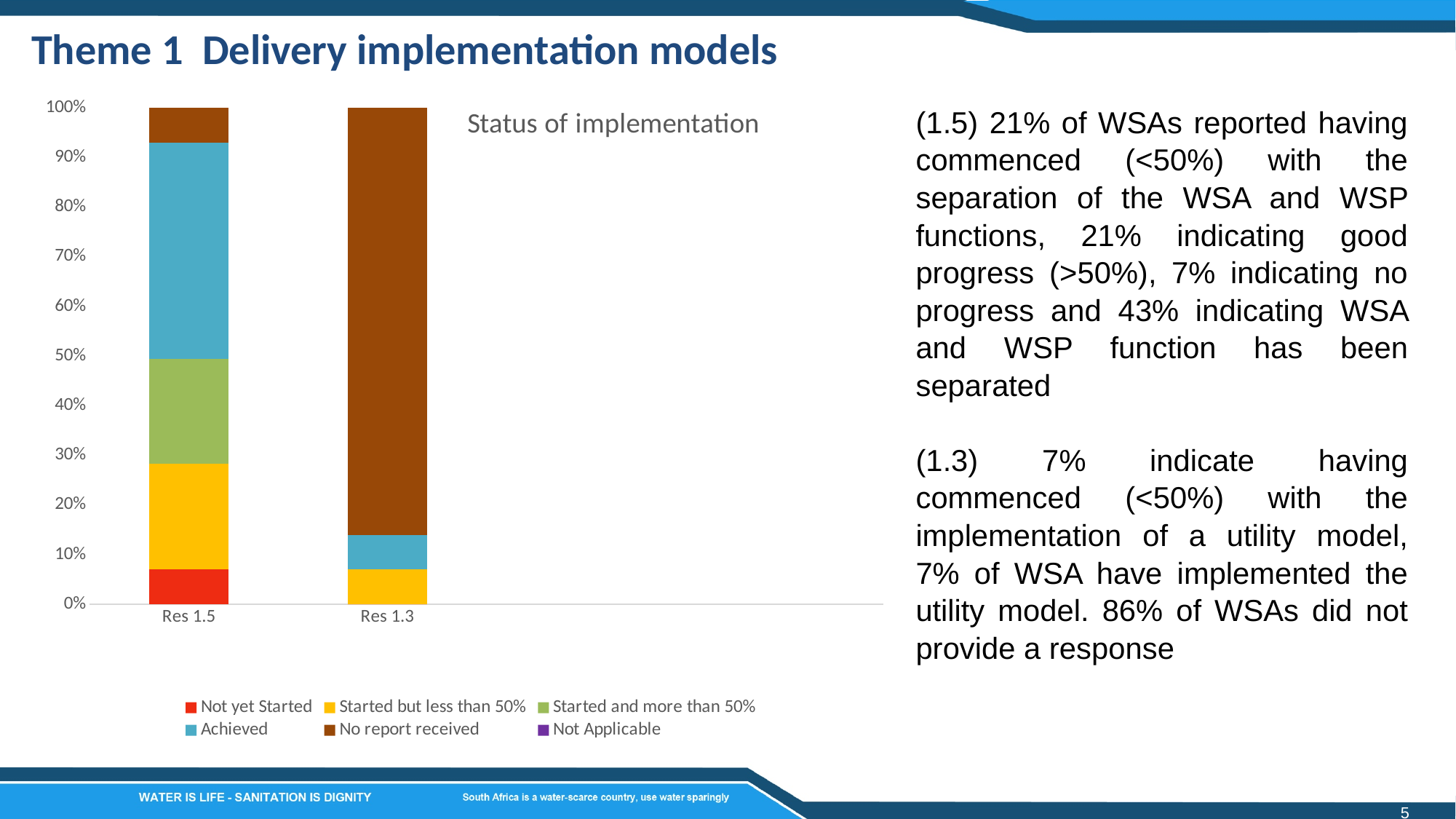
Which series makes up the largest portion of the Res 1.5 bar? Achieved Which bar has the larger 'Achieved' share, Res 1.5 or Res 1.3? Res 1.5 How many categories are shown on the x axis of the chart? 2 Which legend series does not appear as a visible segment in either bar? Not Applicable How many series does the chart legend list? 6 Which bar has the larger 'No report received' share, Res 1.5 or Res 1.3? Res 1.3 Is the 'No report received' share for Res 1.3 greater or less than 80%? greater Which series makes up the largest portion of the Res 1.3 bar? No report received What kind of chart is shown on the slide? Stacked bar chart What is the total height of the Res 1.5 stacked bar? 100% Is the 'Not yet Started' share for Res 1.5 greater or less than 10%? less What is the title of the chart? Status of implementation